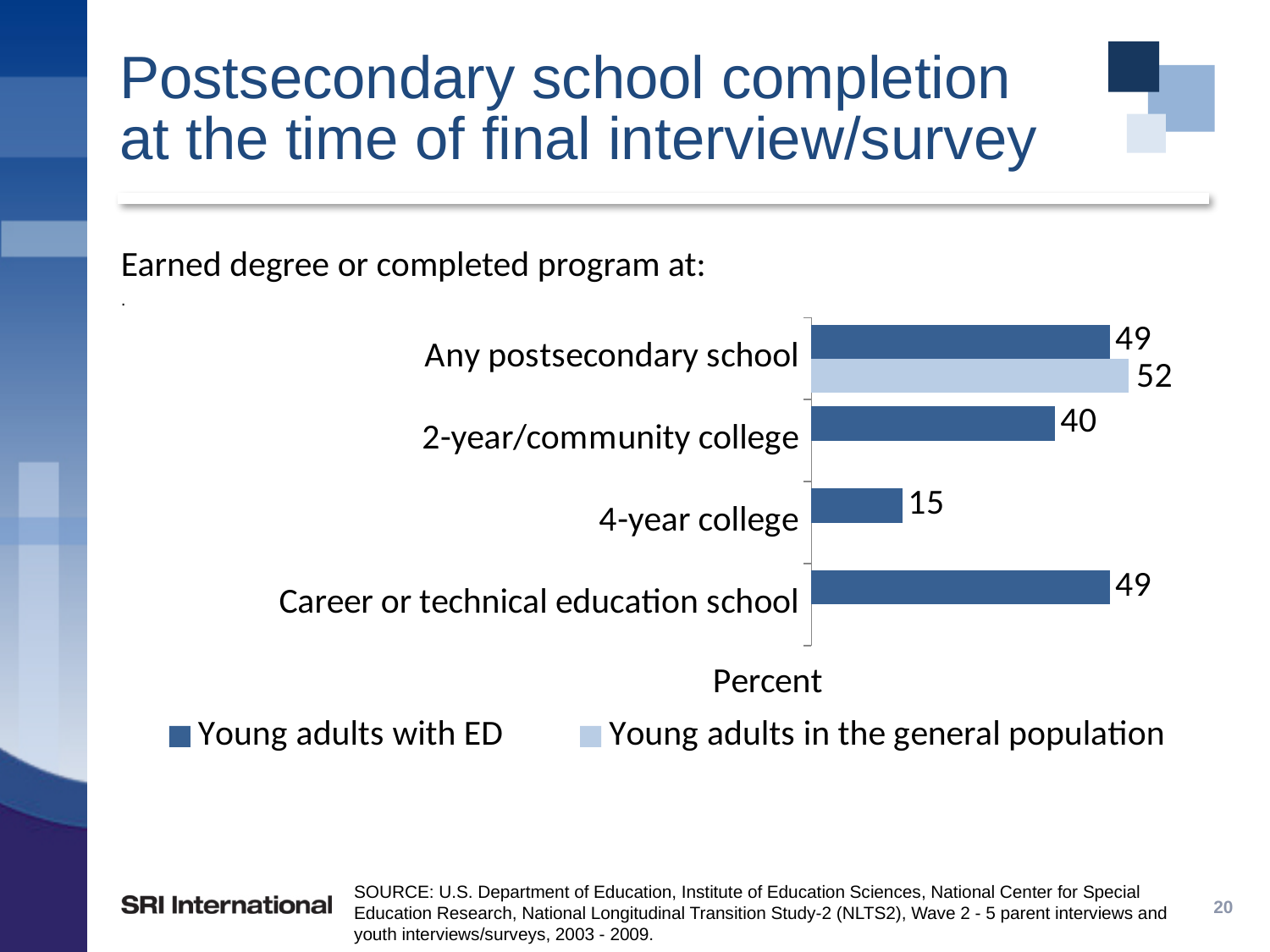
What is the value for Young adults in the general population at Any postsecondary school? 52 What is the value for Young adults with ED at Career or technical education school? 49 Which category has the lowest value for Young adults with ED? 4-year college What is the value for Young adults with ED at 2-year/community college? 40 What is the value for Young adults with ED at Any postsecondary school? 49 How many categories are shown on the chart? 4 What is the difference between the Young adults with ED values for 2-year/community college and 4-year college? 25 What kind of chart is shown on the slide? Bar chart How many series does the legend list? 2 What is the difference between the Young adults in the general population value and the Young adults with ED value for Any postsecondary school? 3 What is the value for Young adults with ED at 4-year college? 15 For Any postsecondary school, which series has the larger value: Young adults with ED or Young adults in the general population? Young adults in the general population